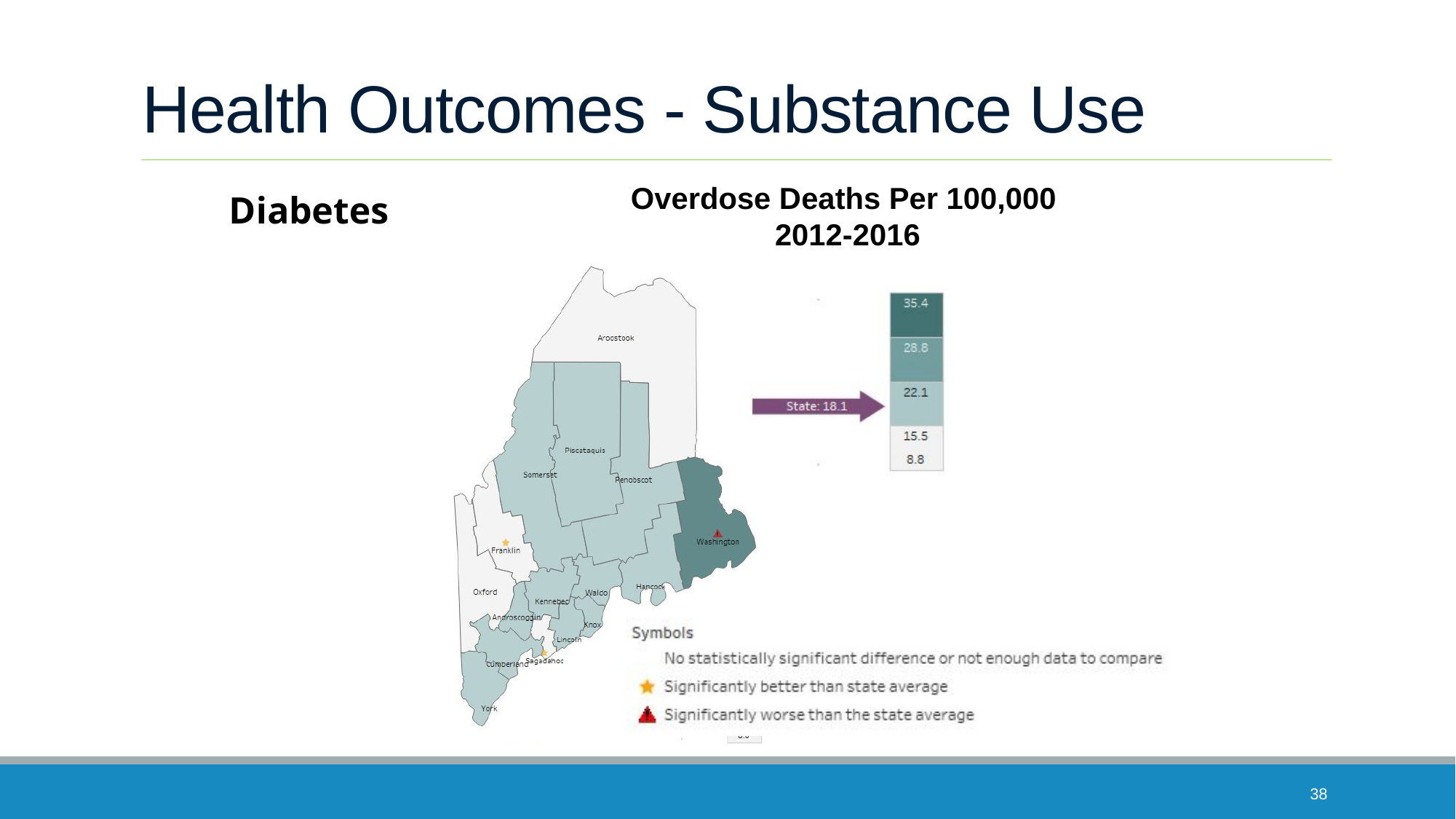
Is the value for Washington county greater or less than 22.1? greater What kind of chart is shown on the slide? map Which counties are marked with a star as significantly better than the state average? Franklin and Sagadahoc What is the title of the map chart on the slide? Overdose Deaths Per 100,000 2012-2016 According to the Symbols key, what does the star symbol mean? Significantly better than state average What is the highest value shown on the map's colour scale? 35.4 What is the state value for overdose deaths per 100,000 shown on the map? 18.1 Is the state value of 18.1 greater or less than 22.1 on the colour scale? less How many counties are labelled on the map? 16 Which county is marked as significantly worse than the state average? Washington Which county is shaded darkest on the overdose deaths map? Washington What is the lowest value shown on the map's colour scale? 8.8